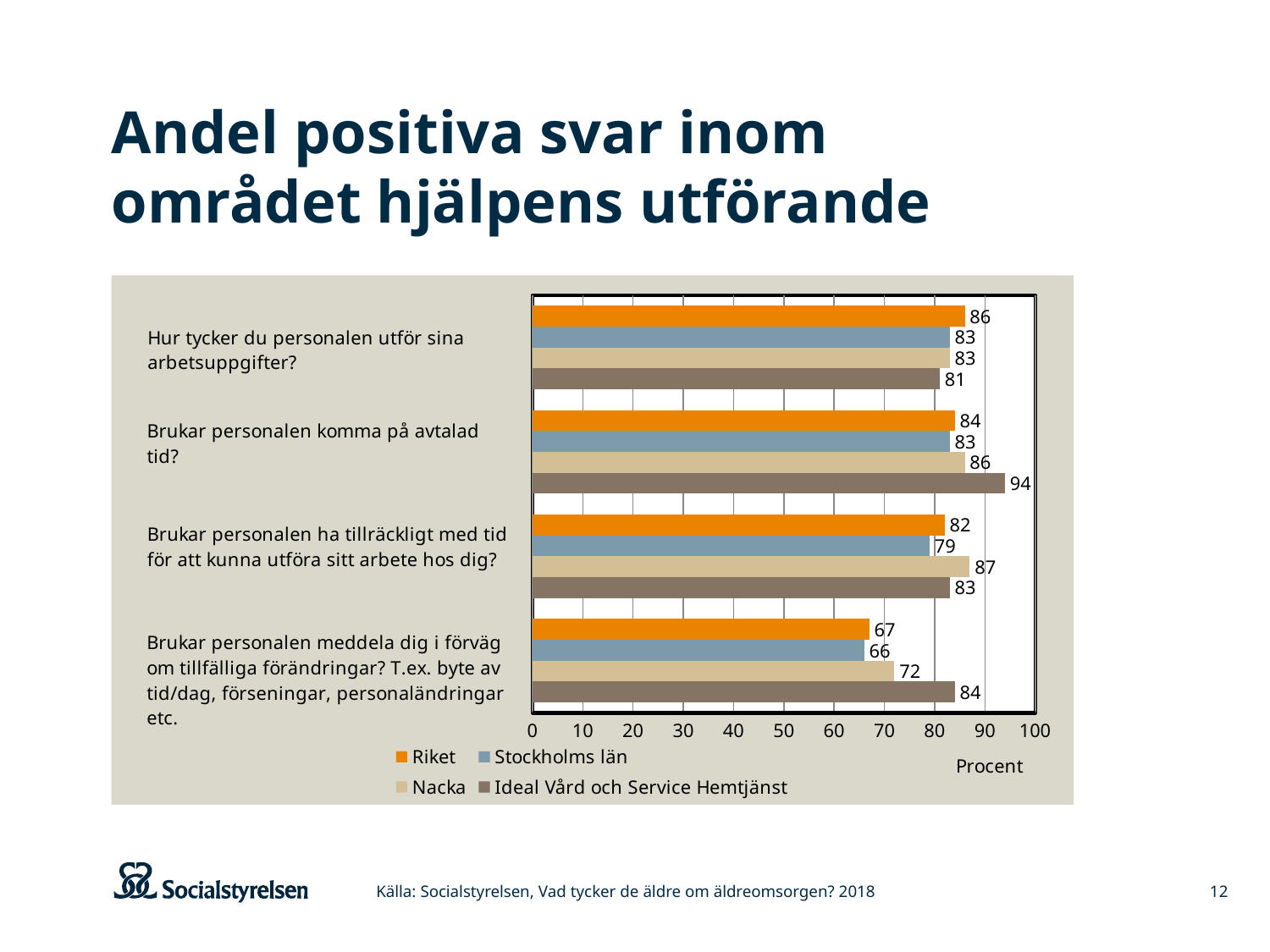
What unit is shown on the x axis of the chart? Procent For "Brukar personalen ha tillräckligt med tid för att kunna utföra sitt arbete hos dig?", which is larger: Nacka or Riket? Nacka Which series has the highest value for "Brukar personalen komma på avtalad tid?"? Ideal Vård och Service Hemtjänst Which series has the lowest value for "Brukar personalen meddela dig i förväg om tillfälliga förändringar?"? Stockholms län What is the difference between Ideal Vård och Service Hemtjänst and Riket for "Brukar personalen meddela dig i förväg om tillfälliga förändringar?"? 17 What is the value for Riket for "Hur tycker du personalen utför sina arbetsuppgifter?"? 86 What is the value for Nacka for "Brukar personalen meddela dig i förväg om tillfälliga förändringar?"? 72 What is the value for Ideal Vård och Service Hemtjänst for "Brukar personalen komma på avtalad tid?"? 94 What is the value for Stockholms län for "Brukar personalen ha tillräckligt med tid för att kunna utföra sitt arbete hos dig?"? 79 How many question categories are plotted on the chart? 4 How many series does the legend list? 4 What type of chart is shown on the slide? Bar chart